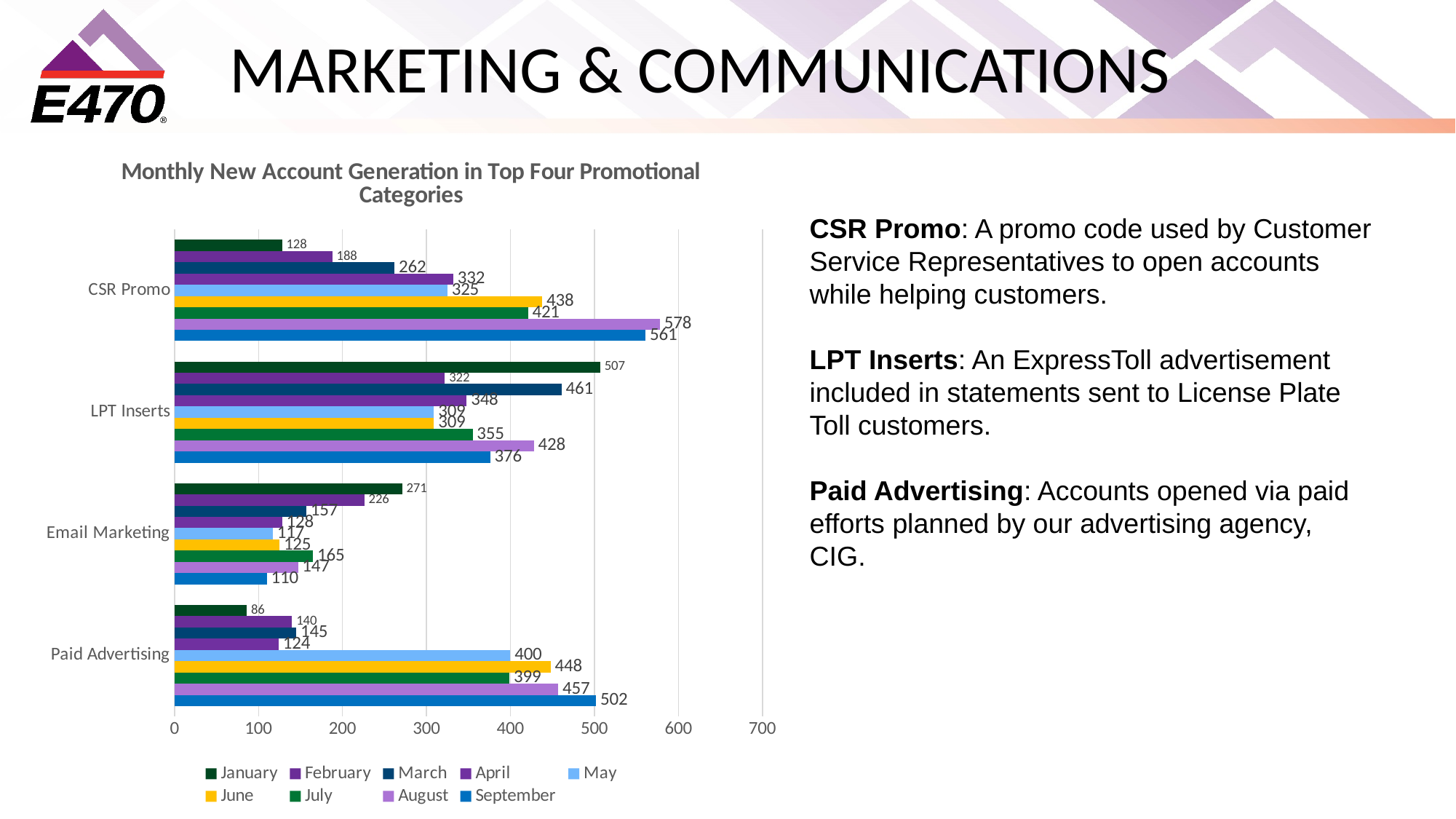
Which month has the lowest value in the Paid Advertising category? January How many promotional categories are shown on the chart? 4 What is the value for August in the CSR Promo category? 578 What kind of chart is shown on the slide? bar chart How many series does the legend list? 9 In the LPT Inserts category, which is larger: the March value or the August value? March What is the value for September in the Paid Advertising category? 502 What is the title of the chart? Monthly New Account Generation in Top Four Promotional Categories What is the value for January in the LPT Inserts category? 507 Which month has the highest value in the CSR Promo category? August Is the value for January in the Email Marketing category greater or less than 200? greater What is the difference between the August and September values in the CSR Promo category? 17